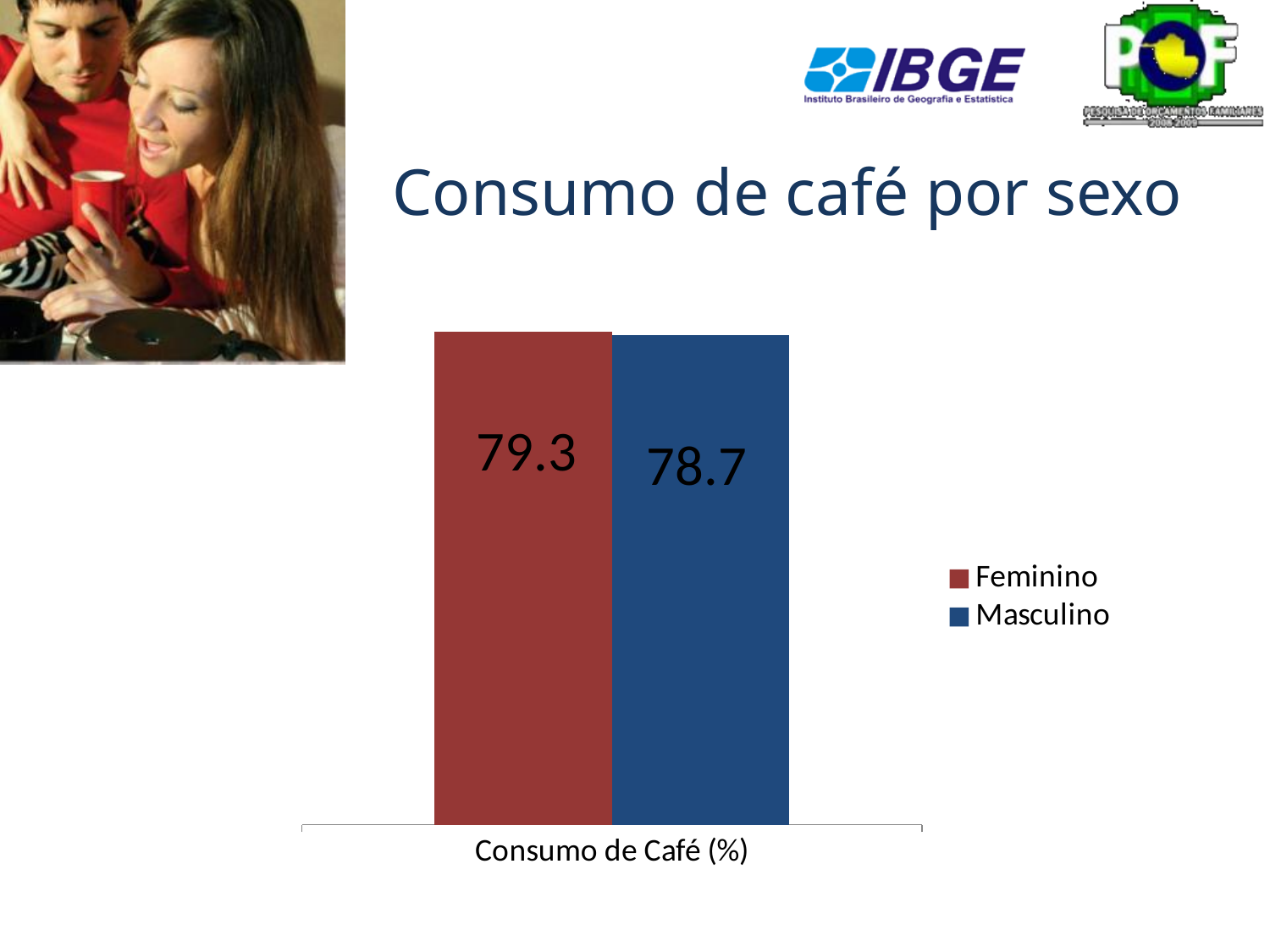
How many series does the legend list? 2 Which series has the higher value, Feminino or Masculino? Feminino What is the difference between the Feminino and Masculino values? 0.6 What kind of chart is shown on the slide? Bar chart What is the title of the chart on the slide? Consumo de café por sexo What is the value for Feminino in the chart? 79.3 What is the value for Masculino in the chart? 78.7 Which series has the lowest value in the chart? Masculino What is the category label shown on the x axis of the chart? Consumo de Café (%) How many bars are plotted in the chart? 2 Which series has the highest value in the chart? Feminino